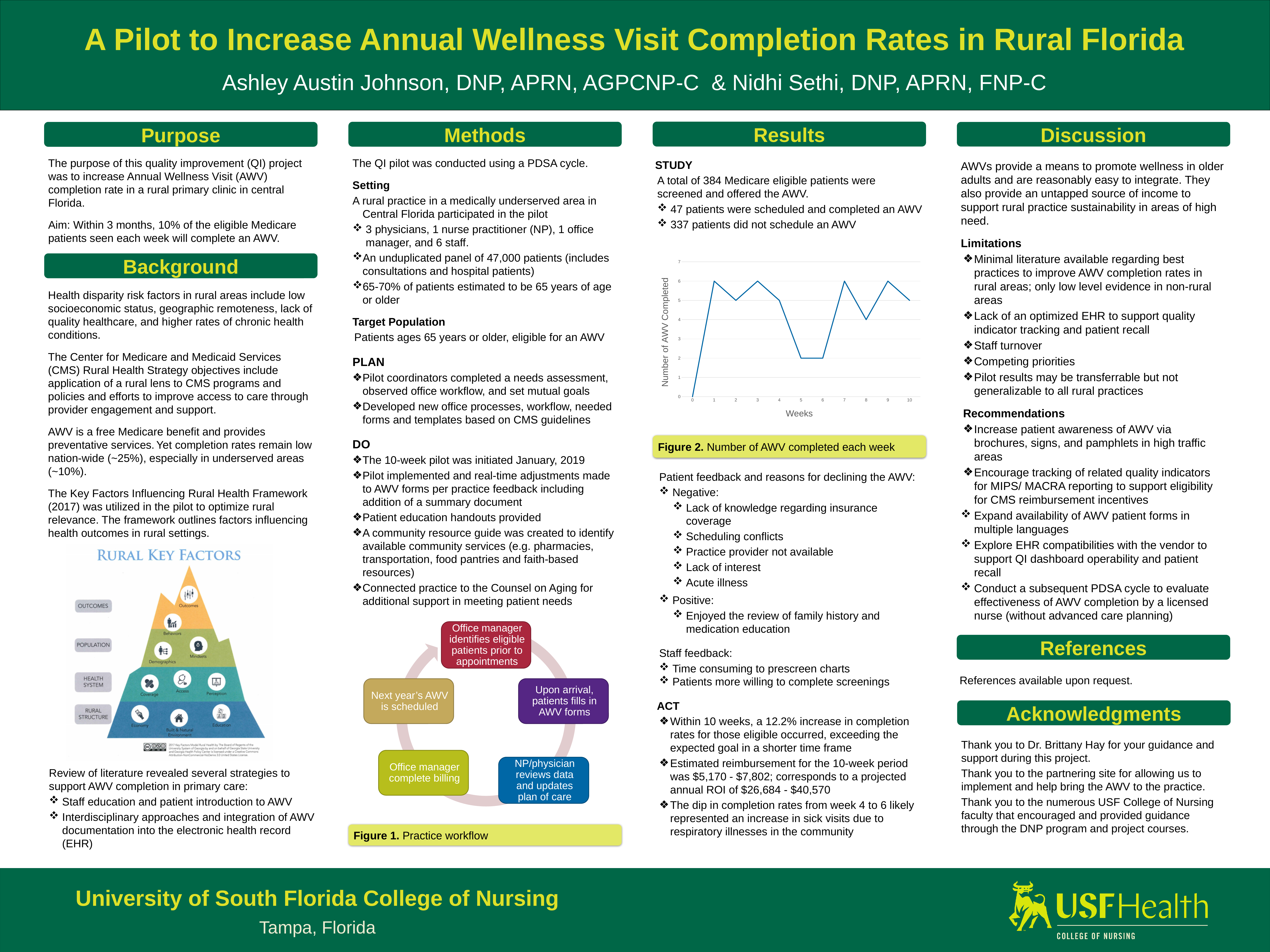
In Figure 2, which week had more AWVs completed, week 4 or week 5? Week 4 In Figure 2, how many AWVs were completed in week 5? 2 In Figure 2, how many AWVs were completed in week 8? 4 In Figure 2, how many AWVs were completed in week 1? 6 In Figure 2, what is the difference between the number of AWVs completed in week 7 and in week 8? 2 In Figure 2, does the number of AWVs completed rise or fall from week 4 to week 5? fall What kind of chart is Figure 2 (Number of AWV completed each week)? line chart What is the label on the y axis of Figure 2? Number of AWV Completed What is the label on the x axis of Figure 2? Weeks In Figure 2, which week has the lowest number of AWVs completed? Week 0 In Figure 2, is the number of AWVs completed in week 8 greater or less than 5? less In Figure 2, what is the highest number of AWVs completed in any single week? 6